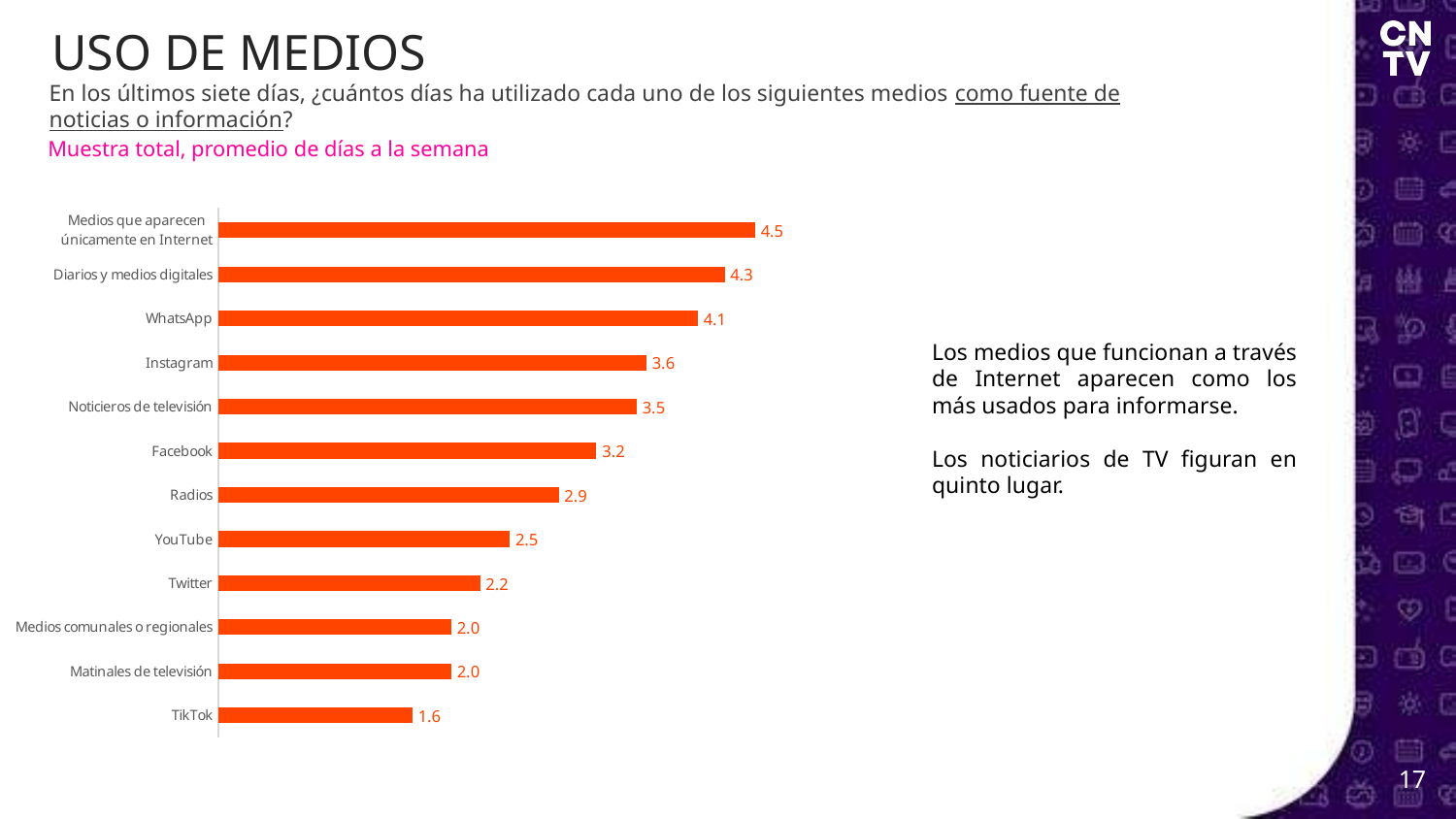
What is the value for Noticieros de televisión? 3.5 How many categories are shown in the chart? 12 What kind of chart is shown on the slide? Bar chart What is the difference between the values for Diarios y medios digitales and YouTube? 1.8 Which is larger, the value for Radios or the value for Twitter? Radios Which category has the highest value? Medios que aparecen únicamente en Internet What is the value for WhatsApp? 4.1 What is the difference between the values for Instagram and Facebook? 0.4 What is the value for TikTok? 1.6 What colour are the bars in the chart? Orange Which category has the lowest value? TikTok What is the value for Medios comunales o regionales? 2.0